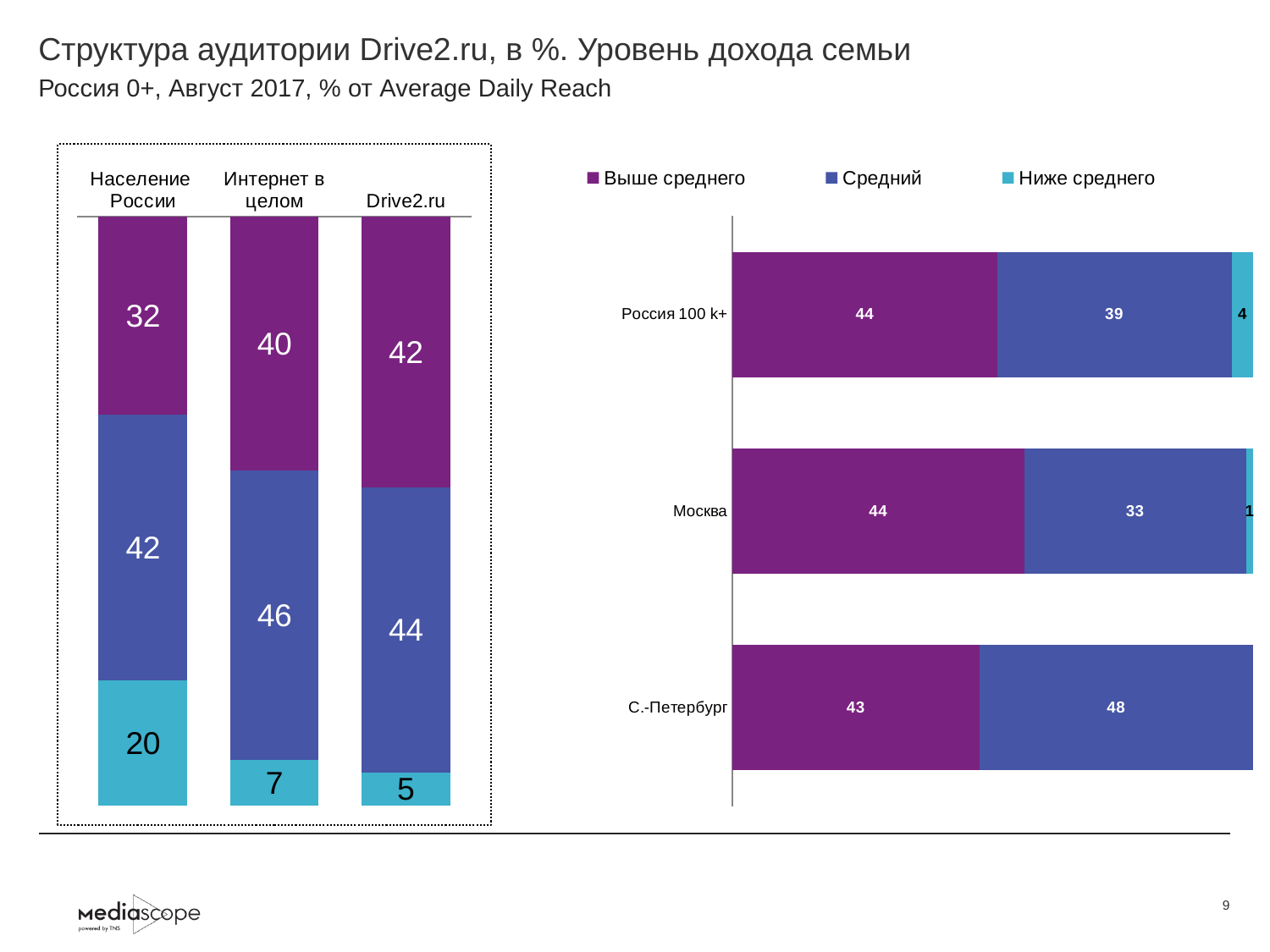
In the right chart, what is the total of the labelled segments for Россия 100 k+? 87 In the left chart, what is the difference between the 'Ниже среднего' values for Население России and Drive2.ru? 15 In the left chart, what is the value of the 'Ниже среднего' segment for Население России? 20 How many categories are shown in the right chart? 3 In the right chart, what is the value of the 'Средний' segment for Москва? 33 In the left chart, which category has the highest 'Средний' value? Интернет в целом In the left chart, which category has the lowest 'Ниже среднего' value? Drive2.ru In the left chart, what is the value of the 'Выше среднего' segment for Drive2.ru? 42 In the right chart, which is larger for С.-Петербург: the 'Средний' segment or the 'Выше среднего' segment? Средний What type of chart is the right chart? Stacked bar chart How many series does the legend of the right chart list? 3 In the right chart, what is the value of the 'Ниже среднего' segment for Россия 100 k+? 4